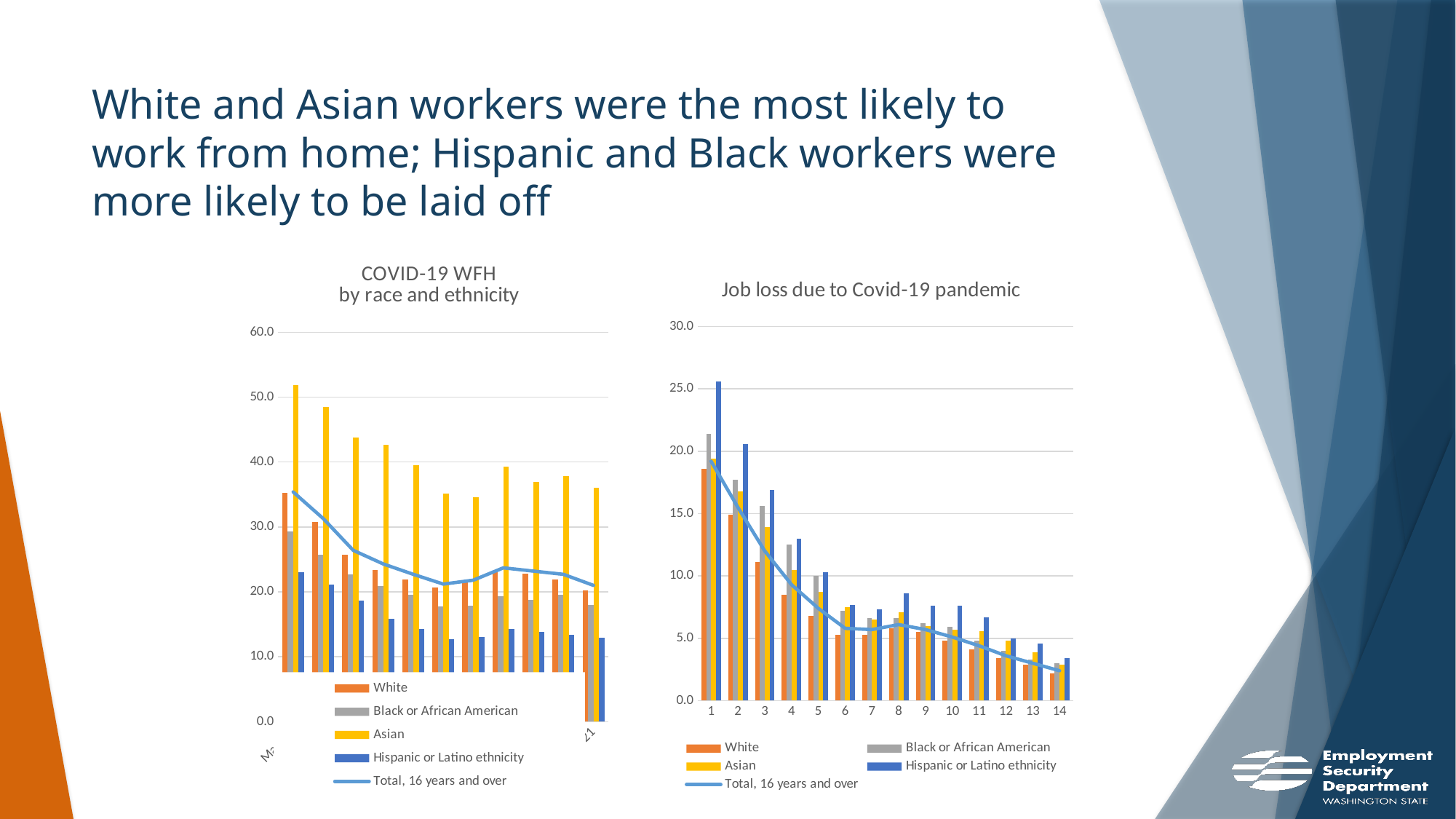
How many series does the legend of the 'COVID-19 WFH by race and ethnicity' chart list? 5 In the 'Job loss due to Covid-19 pandemic' chart, do the values for the 'Total, 16 years and over' line generally rise or fall from category 1 to category 14? fall In the 'COVID-19 WFH by race and ethnicity' chart, is the Asian value in the first group greater or less than 50.0? greater In the 'COVID-19 WFH by race and ethnicity' chart, which series has the highest bar in the first group? Asian What type of chart is the 'Job loss due to Covid-19 pandemic' chart? combination bar and line chart In the 'COVID-19 WFH by race and ethnicity' chart, which is larger in the first group: White or Hispanic or Latino ethnicity? White How many categories are shown on the x axis of the 'Job loss due to Covid-19 pandemic' chart? 14 In the 'Job loss due to Covid-19 pandemic' chart, is the value for White at category 1 greater or less than 20.0? less In the 'Job loss due to Covid-19 pandemic' chart, is the value for Hispanic or Latino ethnicity at category 1 greater or less than 20.0? greater How many series does the legend of the 'Job loss due to Covid-19 pandemic' chart list? 5 In the 'Job loss due to Covid-19 pandemic' chart, which series has the highest bar at category 1? Hispanic or Latino ethnicity In the 'Job loss due to Covid-19 pandemic' chart, which is larger at category 3: White or Hispanic or Latino ethnicity? Hispanic or Latino ethnicity